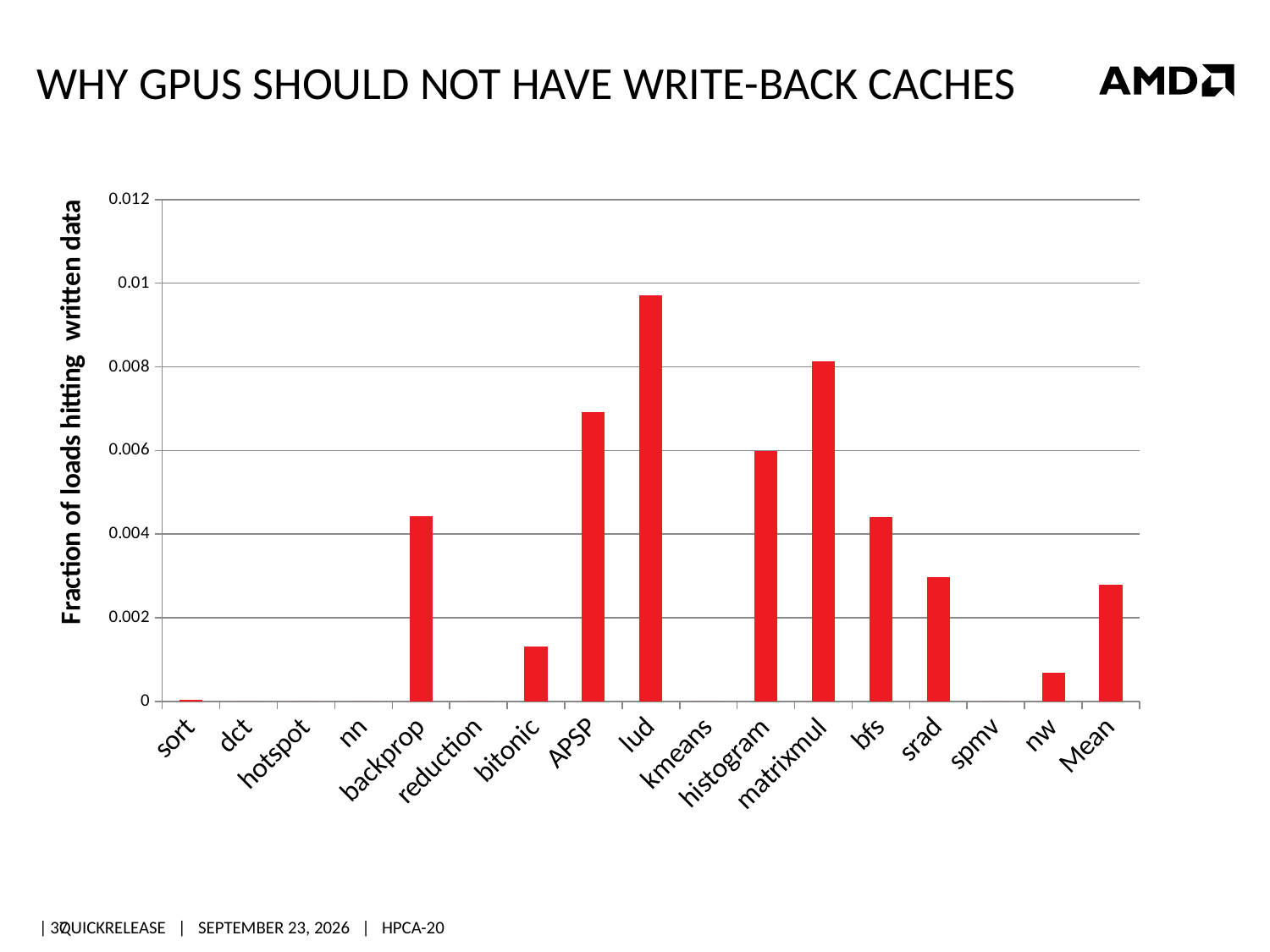
What kind of chart is shown on the slide? bar chart Is the value for bitonic greater or less than 0.002? less Which has a larger value, APSP or histogram? APSP How many categories are shown along the x axis of the chart? 17 Is the value for backprop greater or less than 0.004? greater Is the value for Mean greater or less than 0.004? less Which category has the highest fraction of loads hitting written data? lud What is the label on the y axis of the chart? Fraction of loads hitting written data Which has a larger value, lud or matrixmul? lud